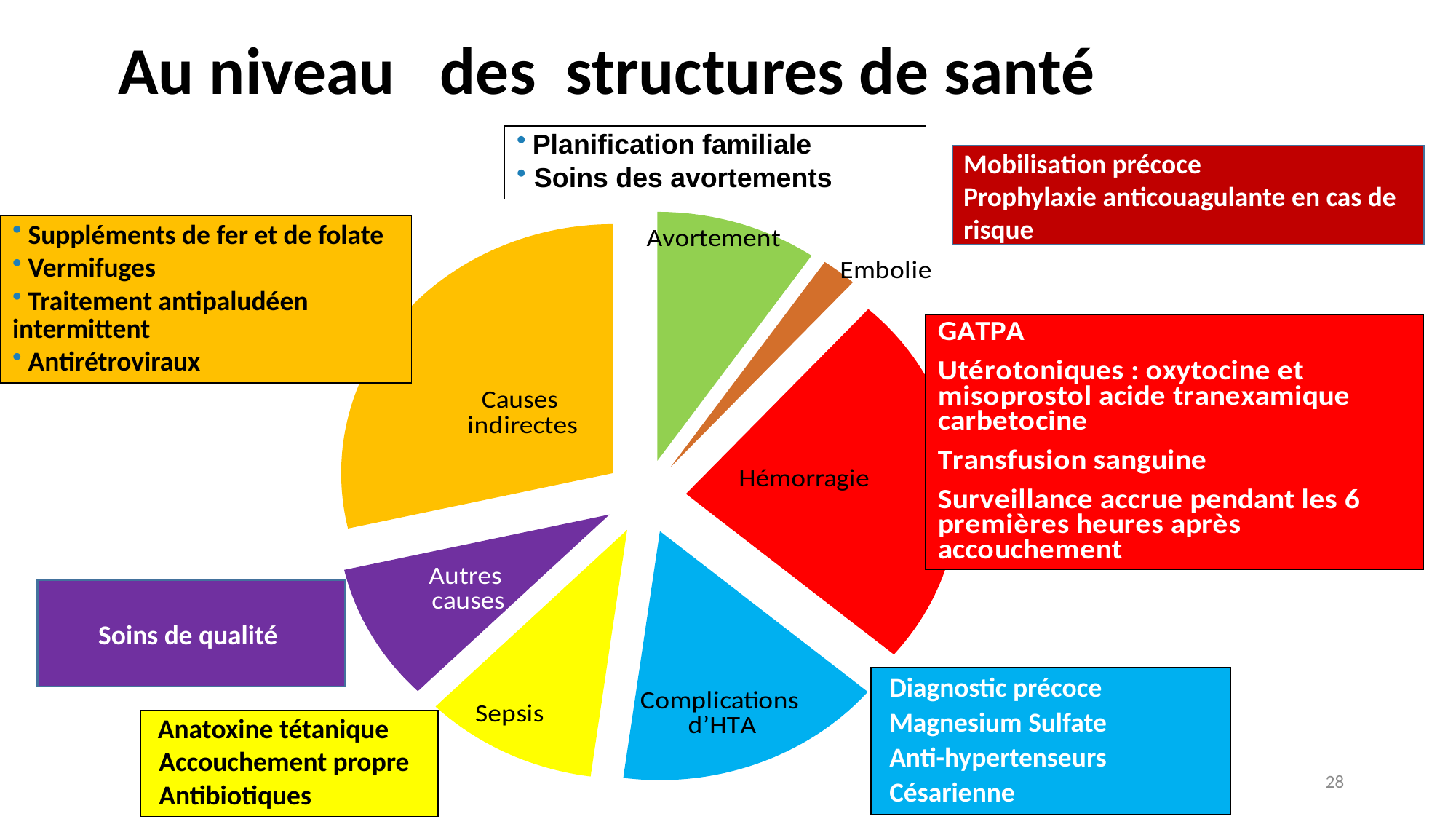
Which slice of the pie chart is the smallest? Embolie Which slice is larger, Autres causes or Embolie? Autres causes Which slice is larger, Hémorragie or Embolie? Hémorragie How many slices does the pie chart have? 7 Which slice is larger, Complications d'HTA or Sepsis? Complications d'HTA What colour is the Hémorragie slice of the pie chart? red What kind of chart is shown on the slide? pie chart Which slice of the pie chart is coloured purple? Autres causes